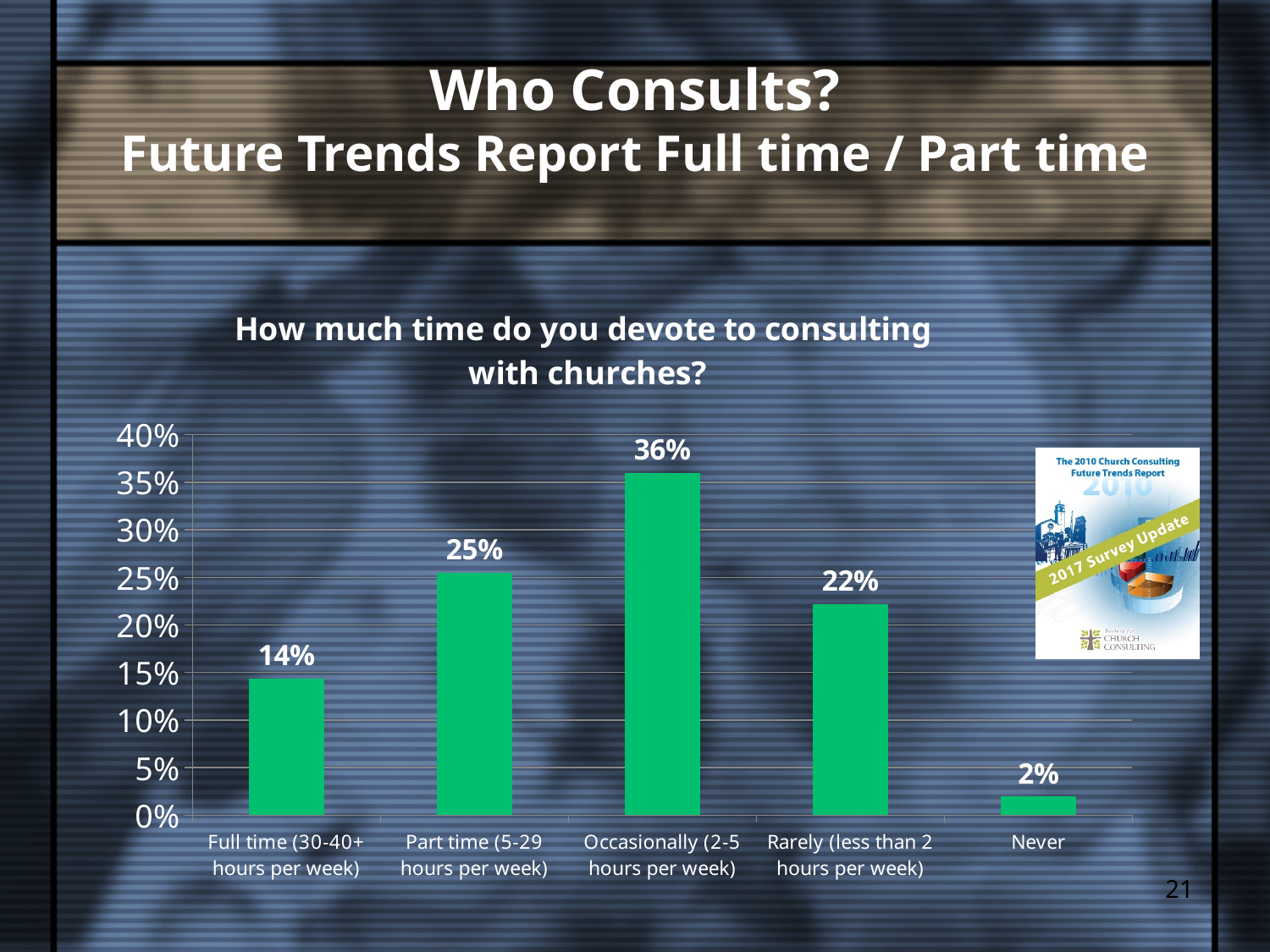
What question is the chart titled with? How much time do you devote to consulting with churches? Which category has the lowest value? Never How many categories are shown on the x axis of the chart? 5 Which is larger, the value for Part time (5-29 hours per week) or the value for Rarely (less than 2 hours per week)? Part time (5-29 hours per week) What kind of chart is shown on the slide? bar chart Which category has the highest value? Occasionally (2-5 hours per week) What is the value for Part time (5-29 hours per week)? 25% What is the difference between the Occasionally (2-5 hours per week) value and the Rarely (less than 2 hours per week) value? 14% What percentage of respondents consult occasionally (2-5 hours per week)? 36% Is the value for Full time (30-40+ hours per week) greater or less than 15%? less What percentage of respondents consult with churches full time (30-40+ hours per week)? 14% What is the value for Never? 2%